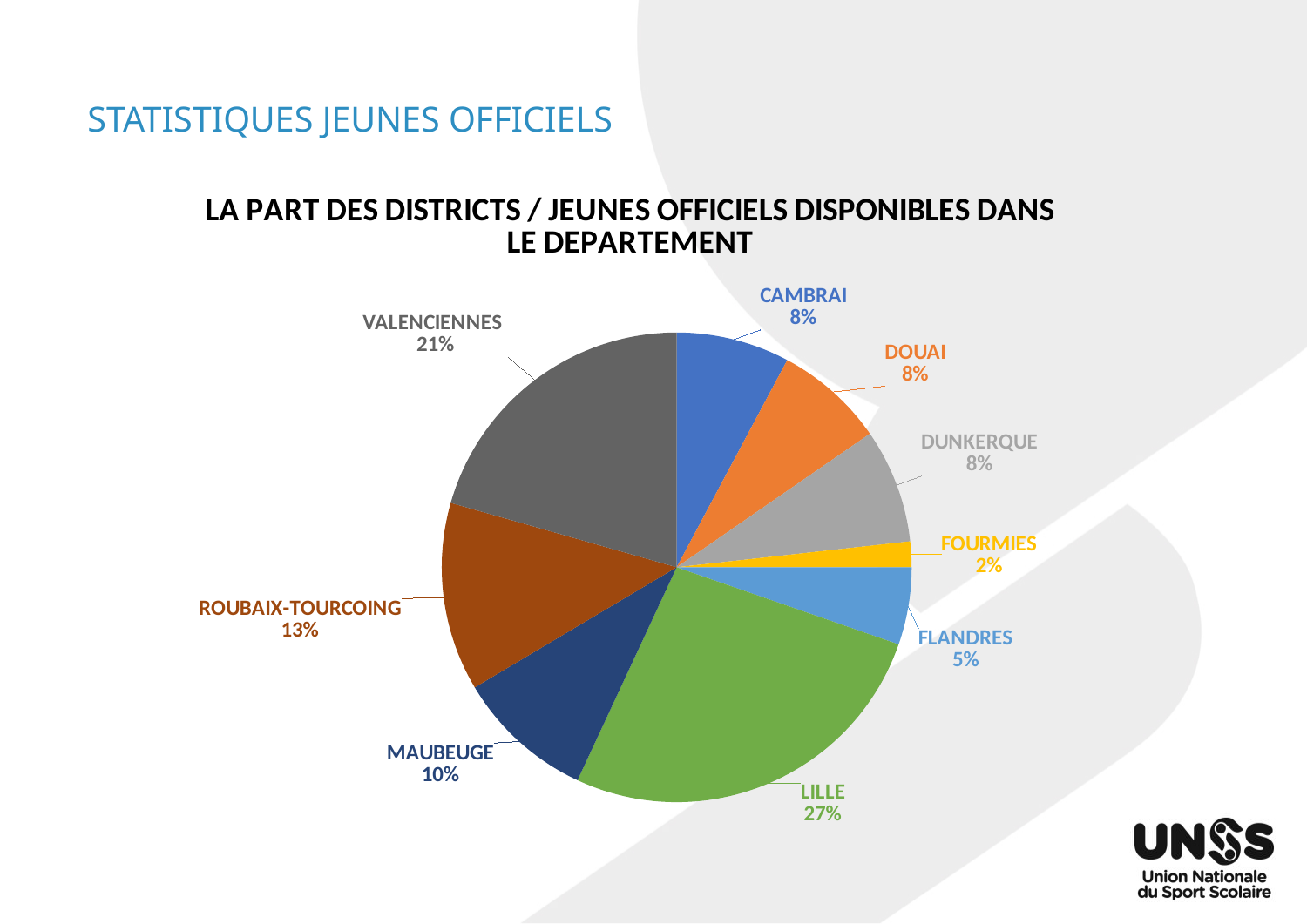
Which district has the largest share in the pie chart? LILLE What is the difference in percentage points between LILLE and VALENCIENNES? 6 What share does ROUBAIX-TOURCOING have in the pie chart? 13% What share does FLANDRES have in the pie chart? 5% What type of chart is shown on the slide? pie chart What share does VALENCIENNES have in the pie chart? 21% Which has a larger share, MAUBEUGE or ROUBAIX-TOURCOING? ROUBAIX-TOURCOING How many districts (slices) are shown in the pie chart? 9 What is the title of the chart? LA PART DES DISTRICTS / JEUNES OFFICIELS DISPONIBLES DANS LE DEPARTEMENT What share does LILLE have in the pie chart? 27% Which district has the smallest share in the pie chart? FOURMIES What share does FOURMIES have in the pie chart? 2%